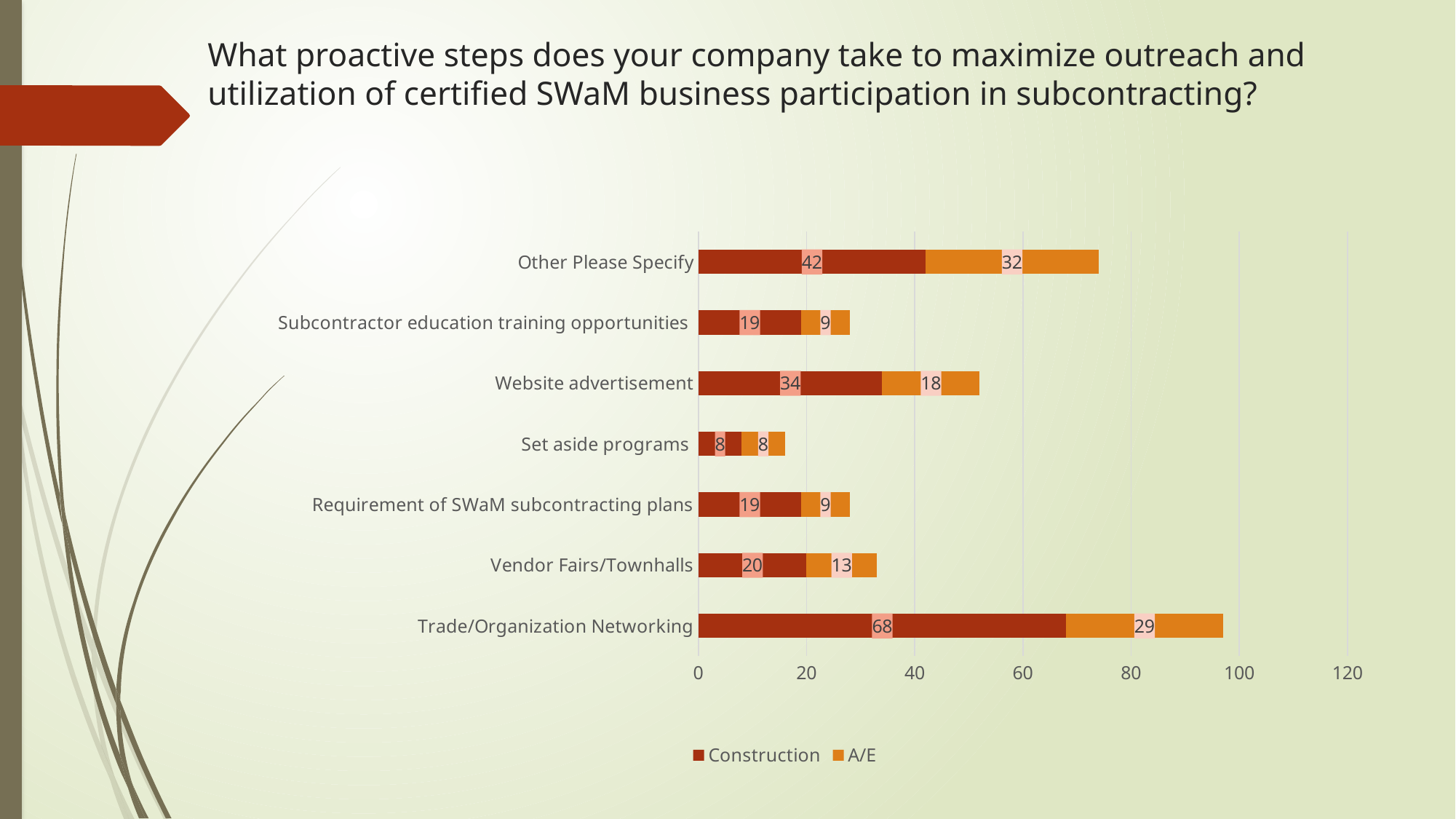
What is the Construction value for Vendor Fairs/Townhalls? 20 What kind of chart is shown on the slide? Stacked bar chart What is the A/E value for Other Please Specify? 32 What is the difference between the Construction values for Other Please Specify and Website advertisement? 8 Which is larger: the A/E value for Trade/Organization Networking or the A/E value for Other Please Specify? Other Please Specify Which category has the highest Construction value? Trade/Organization Networking What is the Construction value for Trade/Organization Networking? 68 How many categories are shown on the chart? 7 Which category has the lowest A/E value? Set aside programs How many series does the legend list? 2 What is the total of the stacked bar for Trade/Organization Networking? 97 What is the A/E value for Website advertisement? 18